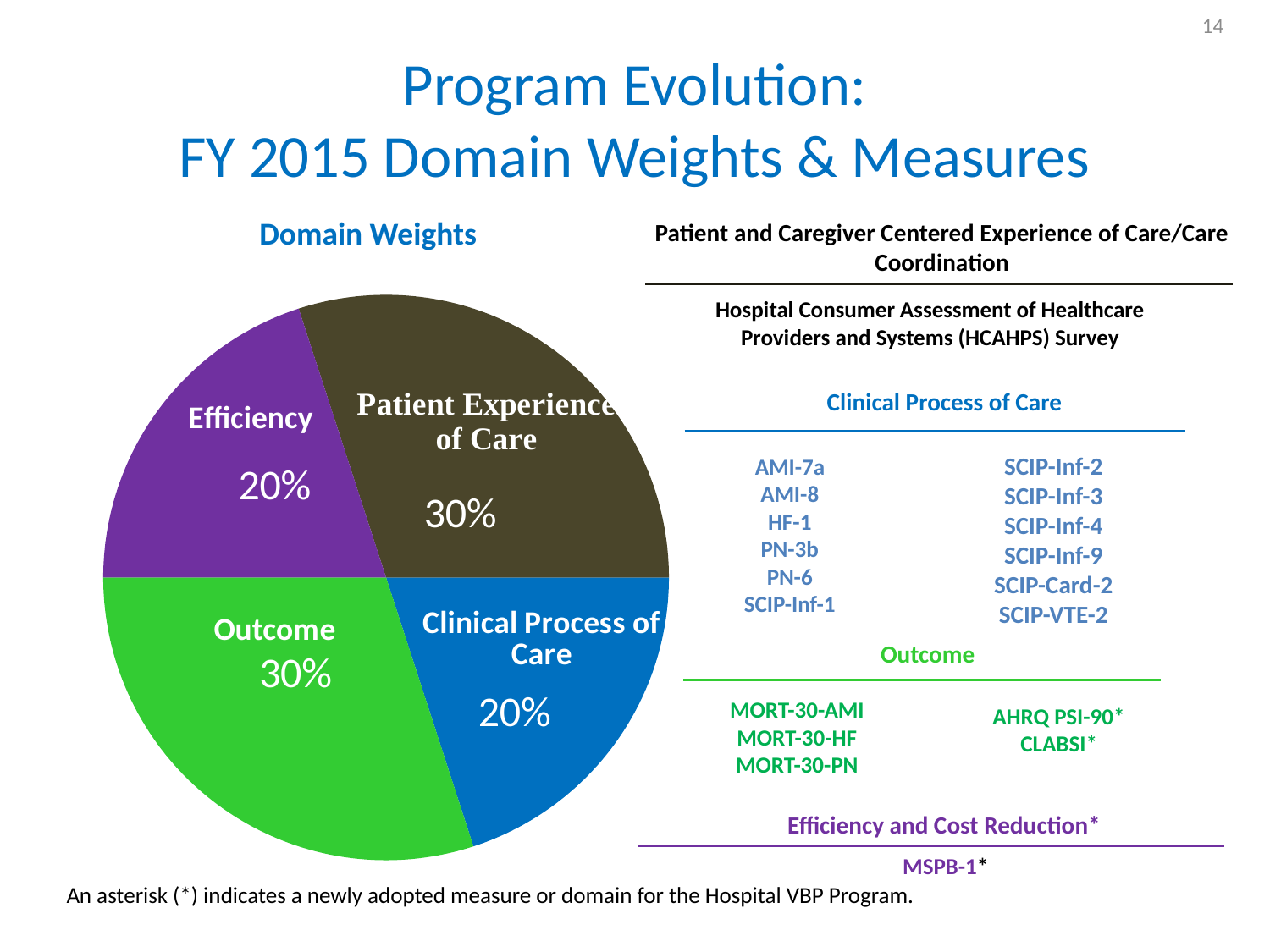
What is the title of the pie chart on the slide? Domain Weights What colour is the Outcome slice in the Domain Weights pie chart? green What kind of chart is shown under the title "Domain Weights"? pie chart What is the weight shown for the Outcome slice of the Domain Weights pie chart? 30% How many slices does the Domain Weights pie chart have? 4 What is the weight shown for the Patient Experience of Care slice of the Domain Weights pie chart? 30% What share of the Domain Weights pie does the Efficiency slice represent? 20% What is the weight shown for the Clinical Process of Care slice of the Domain Weights pie chart? 20% In the Domain Weights pie chart, what is the difference between the Outcome weight and the Clinical Process of Care weight? 10% In the Domain Weights pie chart, which is larger: Clinical Process of Care or Patient Experience of Care? Patient Experience of Care What is the weight shown for the Efficiency slice of the Domain Weights pie chart? 20% In the Domain Weights pie chart, which is larger: Outcome or Efficiency? Outcome